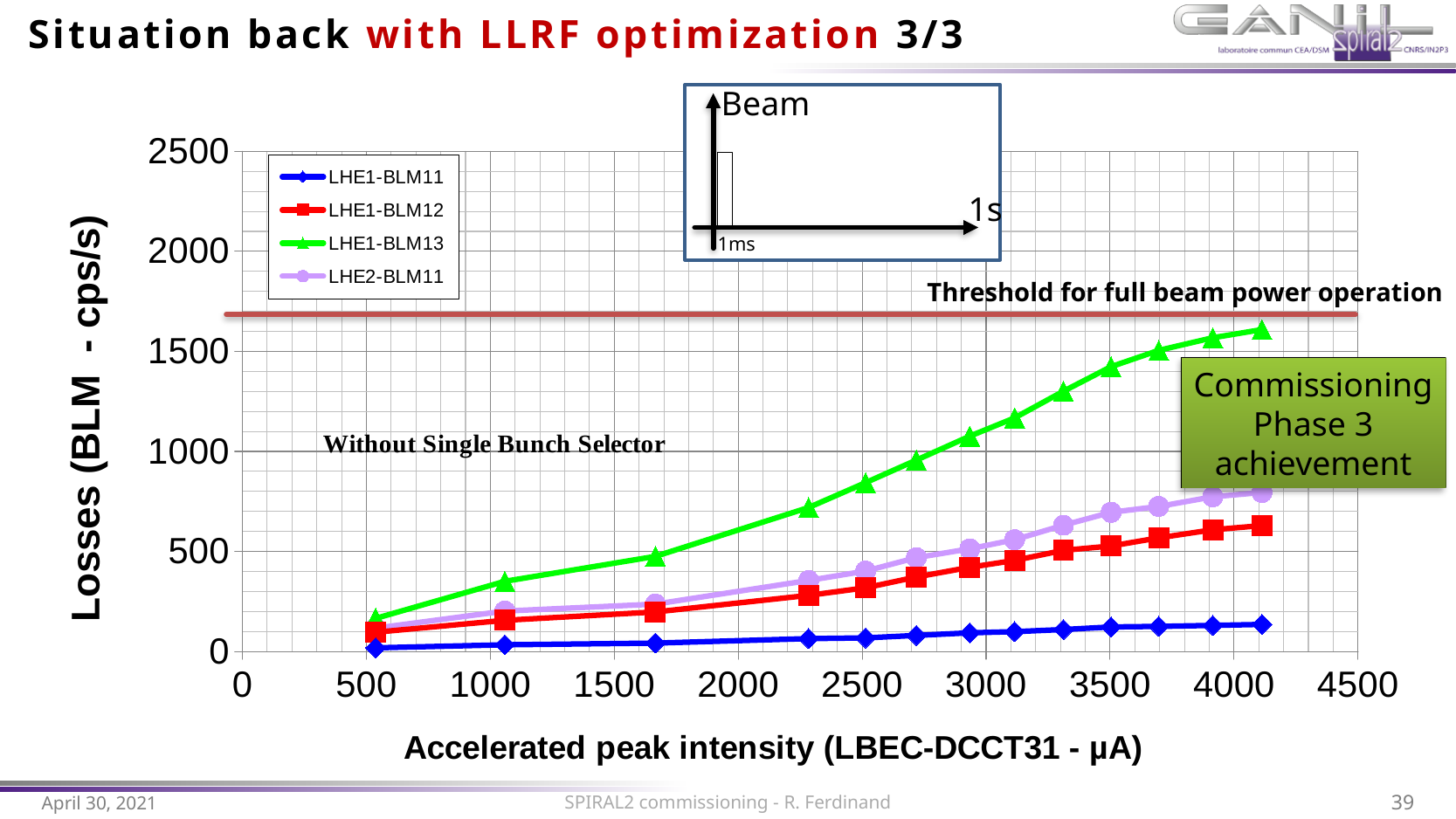
Which series has the lowest losses across the plotted intensity range? LHE1-BLM11 What does the horizontal red line on the chart represent? Threshold for full beam power operation What is the title of the x axis? Accelerated peak intensity (LBEC-DCCT31 - µA) Is the value for LHE1-BLM13 at the highest plotted intensity greater or less than 1500? greater What kind of chart is shown on the slide? line chart Is the value for LHE1-BLM11 at the highest plotted intensity greater or less than 500? less How many series does the legend list? 4 Is the value for LHE1-BLM12 at the highest plotted intensity greater or less than 500? greater Which series has the highest losses at the highest accelerated peak intensity? LHE1-BLM13 At an accelerated peak intensity of about 4000 µA, which series has the larger losses, LHE1-BLM12 or LHE2-BLM11? LHE2-BLM11 Do the losses for LHE1-BLM13 rise or fall as the accelerated peak intensity increases? rise